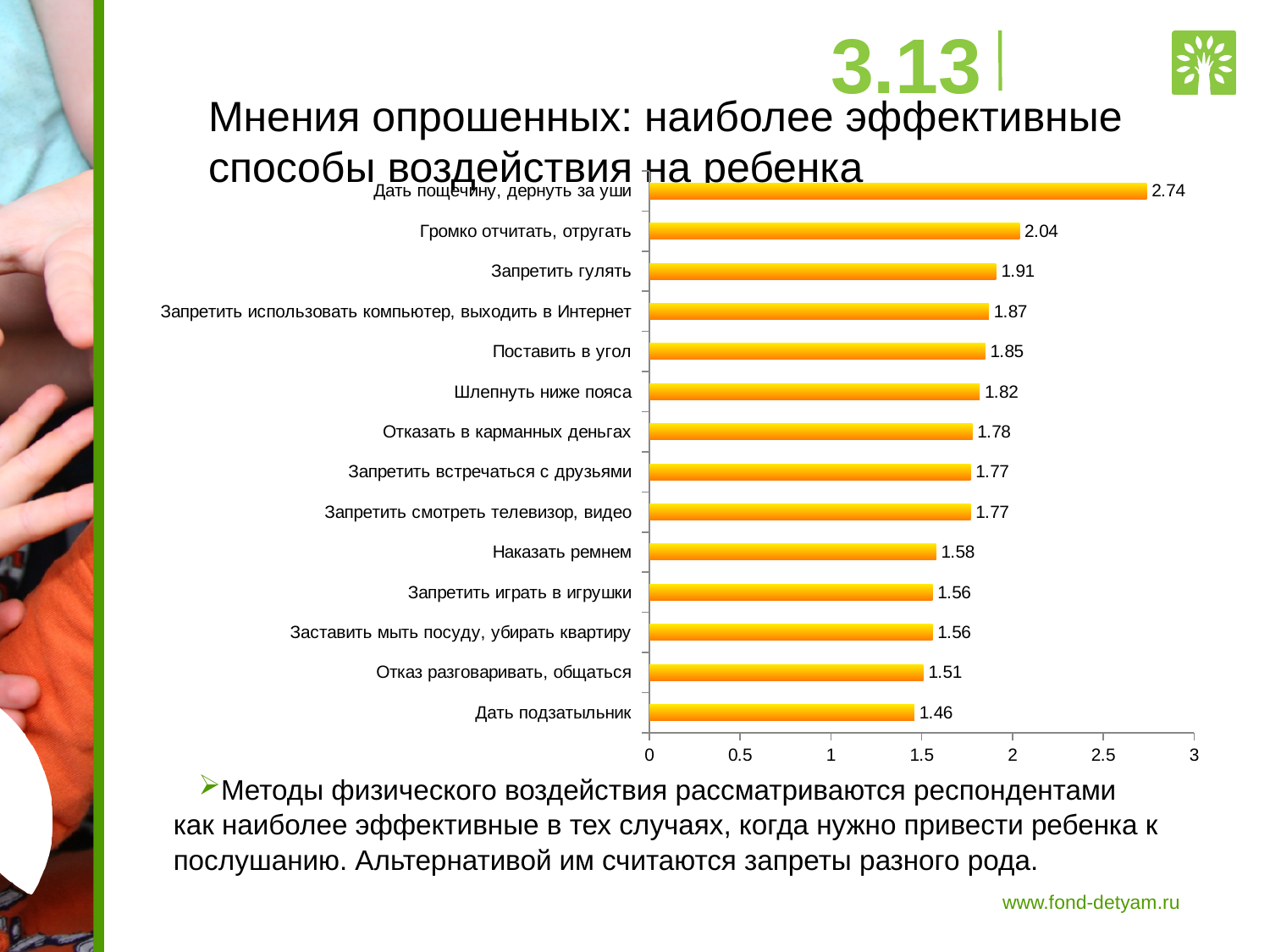
What is the difference between the values for "Дать пощечину, дернуть за уши" and "Громко отчитать, отругать"? 0.7 Which category has the lowest value? Дать подзатыльник What is the value for "Запретить гулять"? 1.91 What kind of chart is shown on the slide? bar chart What is the difference between the values for "Запретить гулять" and "Дать подзатыльник"? 0.45 What is the maximum value shown on the horizontal axis? 3 Is the value for "Громко отчитать, отругать" greater or less than 2? greater How many categories are shown in the chart? 14 What is the value for "Наказать ремнем"? 1.58 What is the value for "Дать пощечину, дернуть за уши"? 2.74 Which is larger: the value for "Поставить в угол" or the value for "Отказ разговаривать, общаться"? Поставить в угол Which category has the highest value? Дать пощечину, дернуть за уши